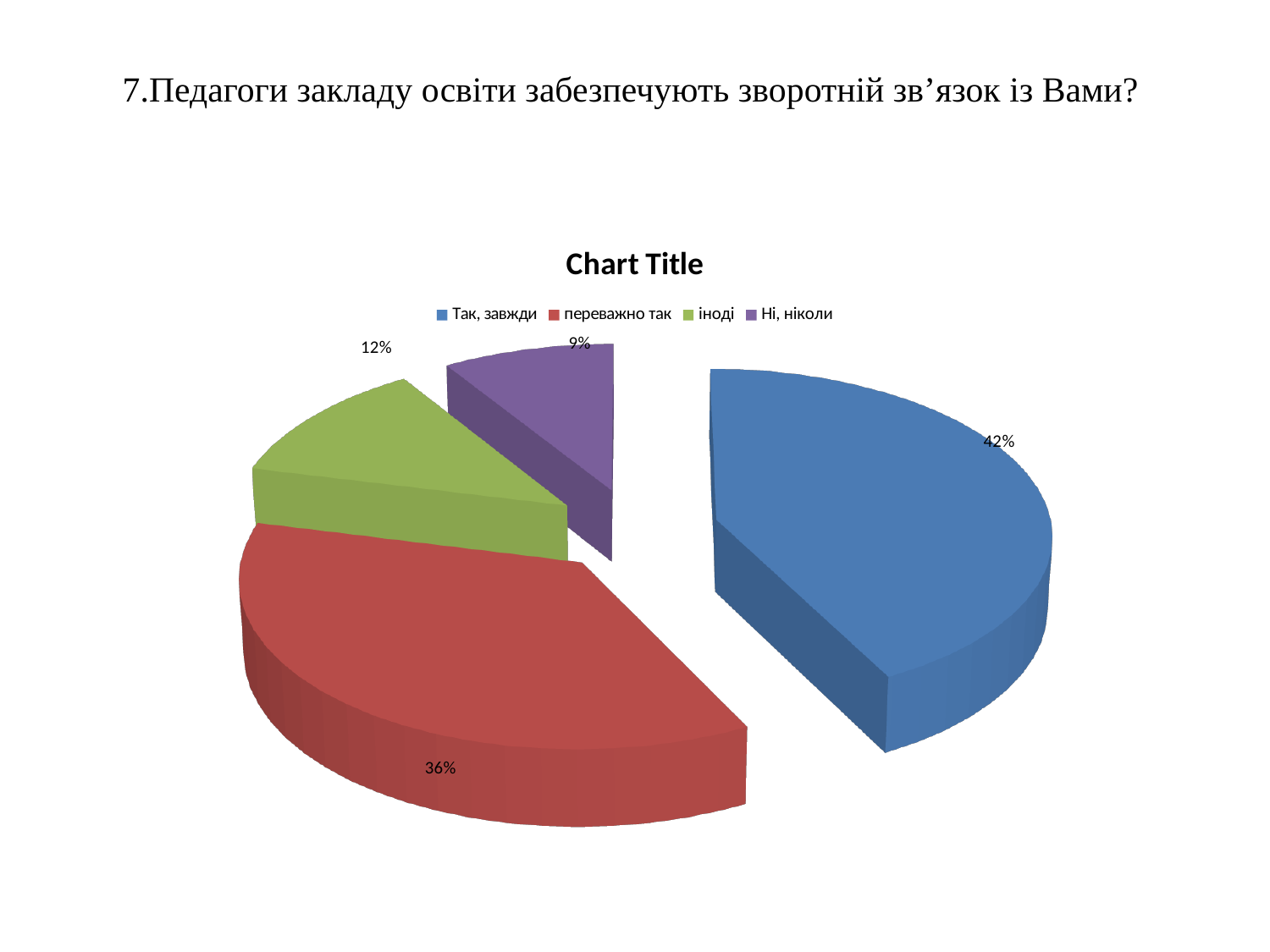
What percentage is shown for "переважно так"? 36% What is the difference in percentage points between "Так, завжди" and "переважно так"? 6 What percentage is shown for "іноді"? 12% Which is larger, the share for "іноді" or the share for "Ні, ніколи"? іноді What percentage is shown for "Так, завжди"? 42% What kind of chart is shown on the slide? pie chart Which category has the largest share of the pie? Так, завжди What colour is the slice for "переважно так"? red What percentage is shown for "Ні, ніколи"? 9% Which category has the smallest share of the pie? Ні, ніколи What is the title shown above the chart? Chart Title How many categories does the legend list? 4